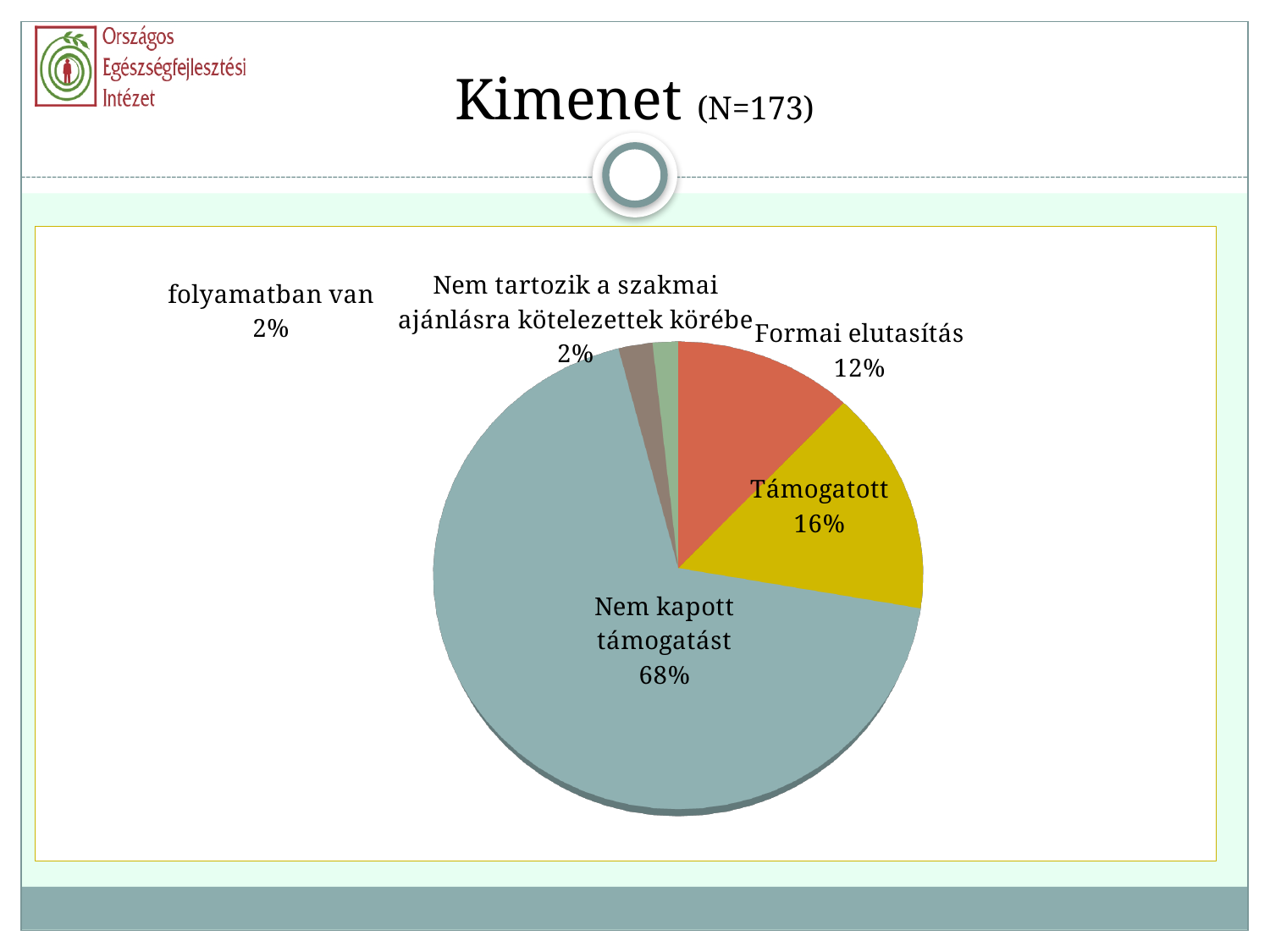
How many slices does the pie chart have? 5 What is the difference in percentage points between "Nem kapott támogatást" and "Támogatott"? 52 What kind of chart is shown on the slide? pie chart What share of the pie is labelled "Támogatott"? 16% What is the difference in percentage points between "Támogatott" and "Formai elutasítás"? 4 What colour is the "Támogatott" slice? yellow What share of the pie is labelled "folyamatban van"? 2% What share of the pie is labelled "Formai elutasítás"? 12% Which is larger, the share for "Támogatott" or the share for "Formai elutasítás"? Támogatott What is the title of the slide containing the chart? Kimenet (N=173) Which category has the largest slice of the pie? Nem kapott támogatást